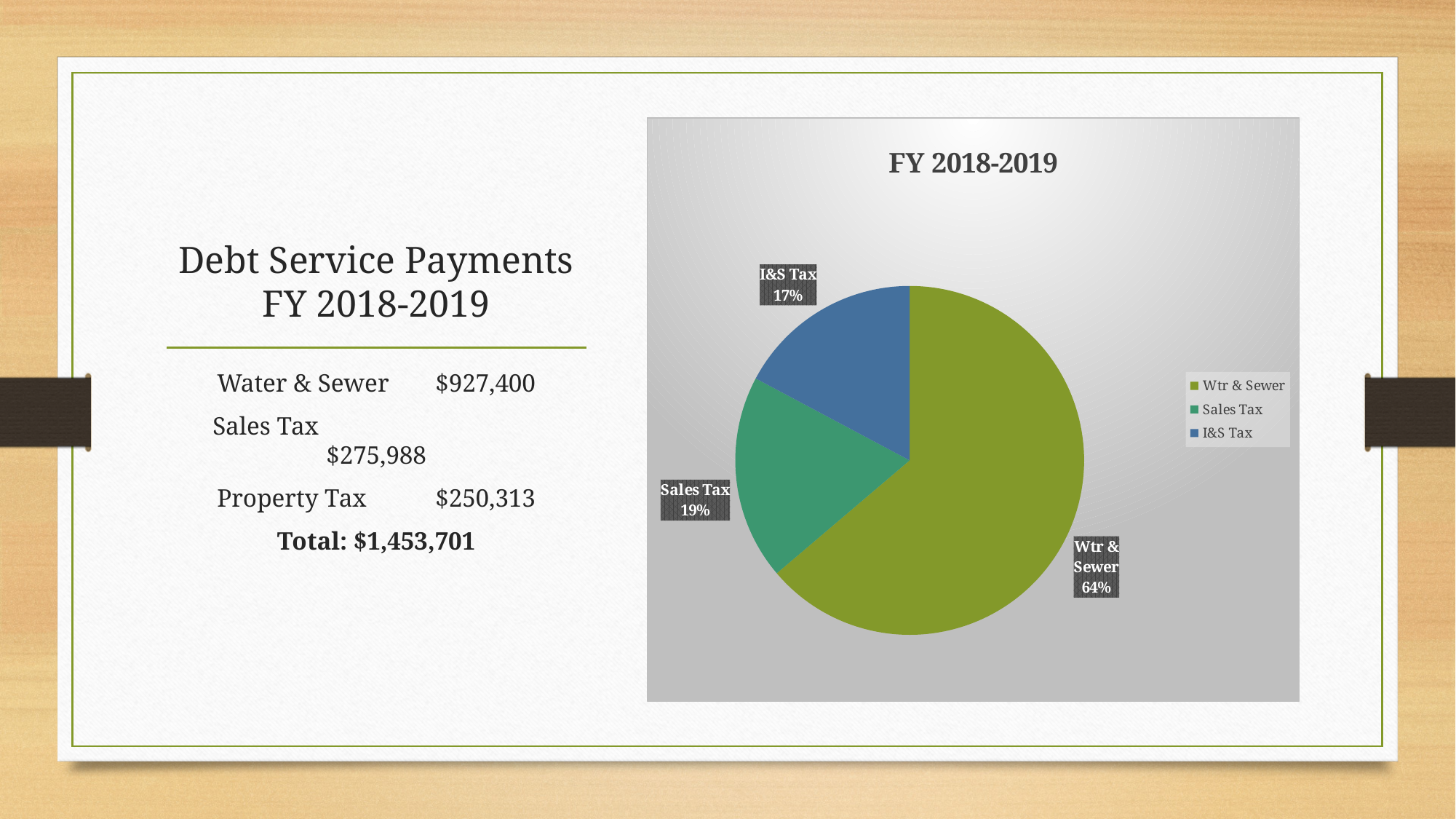
How many slices does the pie chart have? 3 What percentage share does the I&S Tax slice have? 17% What percentage share does the Wtr & Sewer slice have? 64% What is the difference in percentage points between the Wtr & Sewer share and the Sales Tax share? 45 What percentage share does the Sales Tax slice have? 19% What kind of chart is shown on the slide? pie chart Which slice of the pie is the smallest? I&S Tax Which slice is larger, Sales Tax or I&S Tax? Sales Tax How many entries does the legend list? 3 Which slice of the pie is the largest? Wtr & Sewer What is the chart's title? FY 2018-2019 What colour is the Wtr & Sewer slice? green